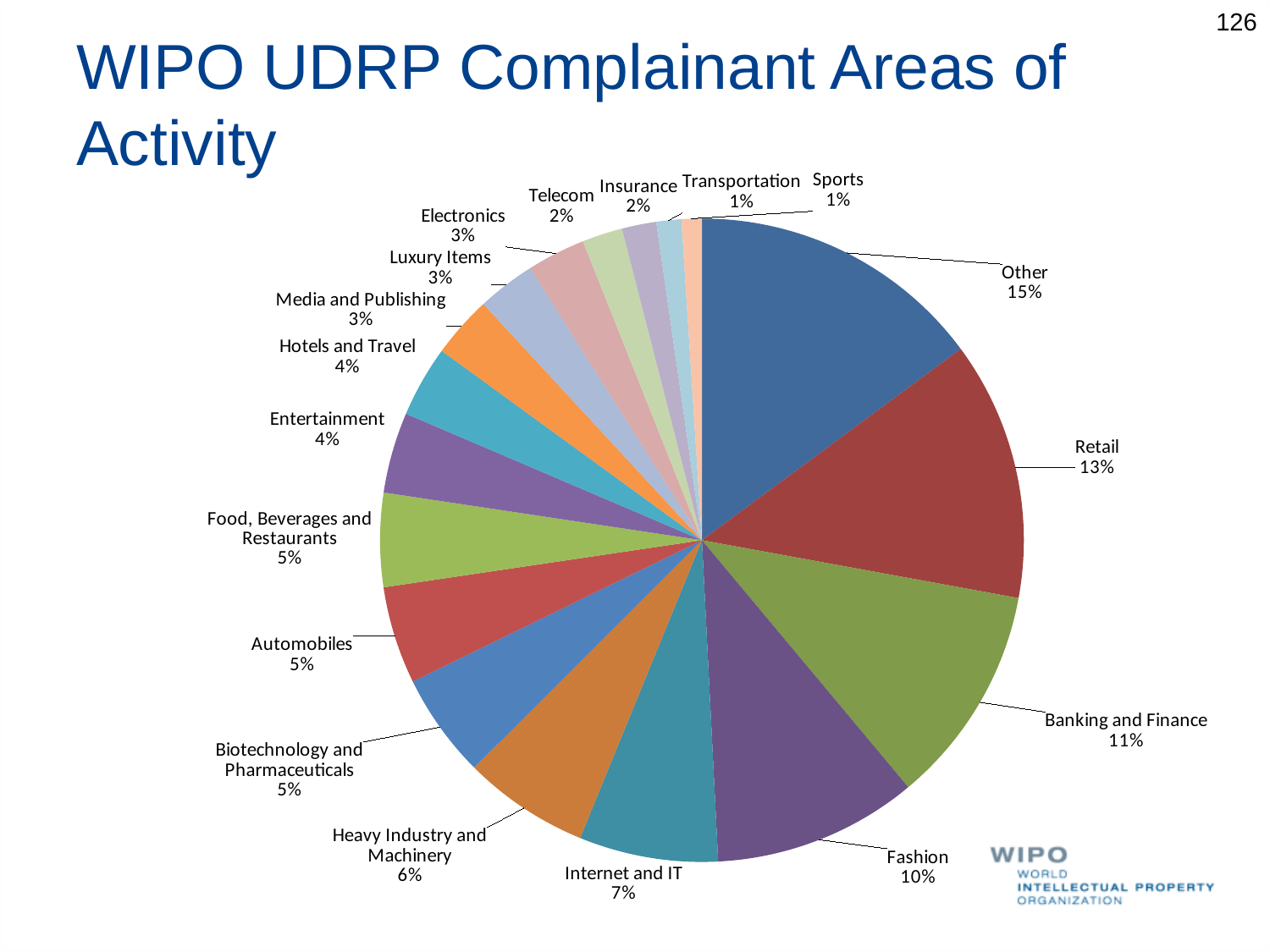
How many categories are shown in the pie chart? 18 Which category has the largest slice of the pie? Other What is the value shown for Internet and IT? 7% What is the difference between the Other share and the Banking and Finance share? 4% What type of chart is shown on the slide? pie chart Which is larger, the share for Retail or the share for Fashion? Retail What share of the pie does Retail account for? 13% What is the title of the chart on the slide? WIPO UDRP Complainant Areas of Activity What is the value shown for Banking and Finance? 11% What is the value shown for Hotels and Travel? 4% What is the difference between the Fashion share and the Entertainment share? 6% What is the value shown for Heavy Industry and Machinery? 6%